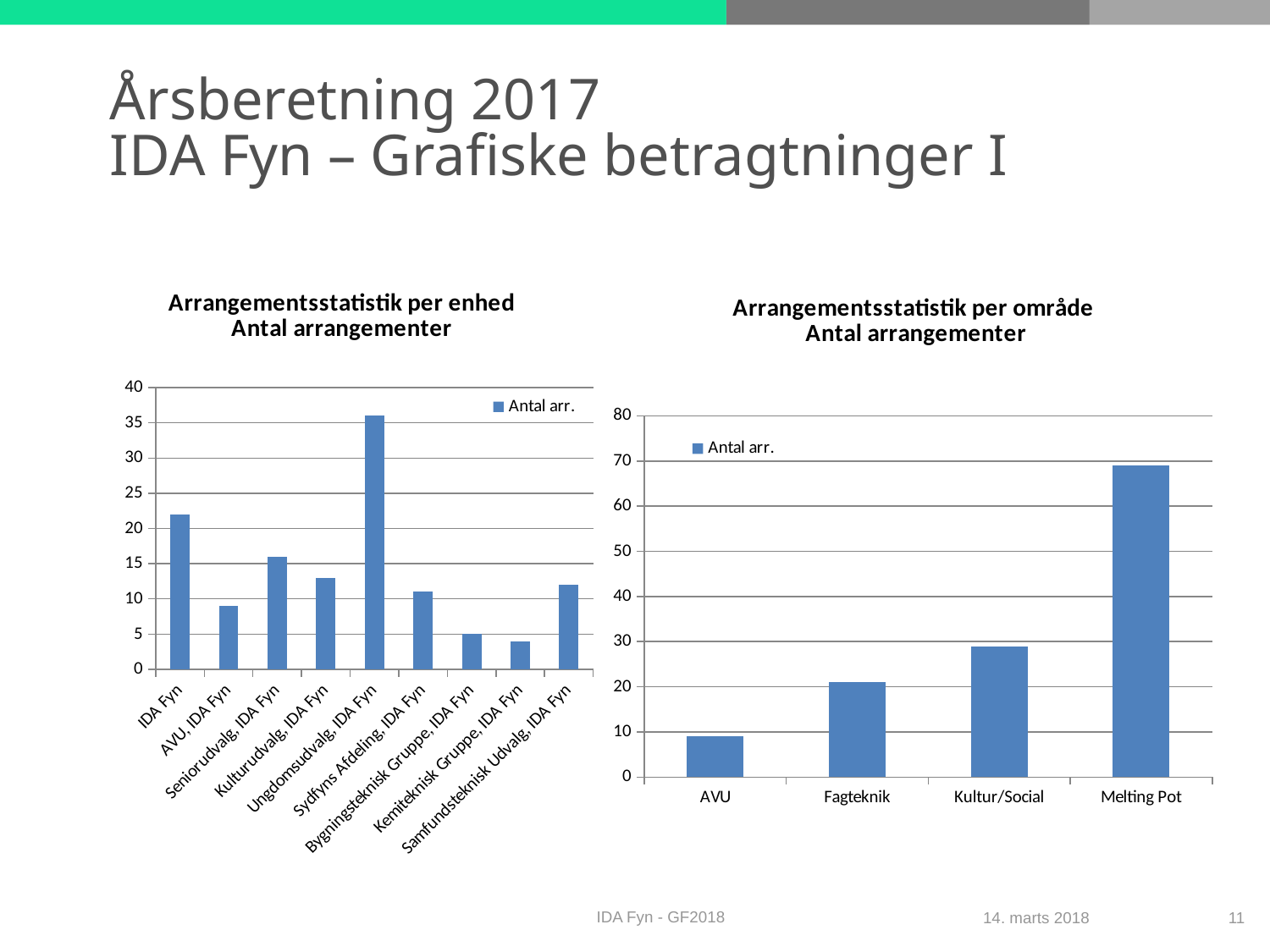
What type of chart is the chart titled 'Arrangementsstatistik per enhed'? Bar chart In the chart titled 'Arrangementsstatistik per enhed', is the value for IDA Fyn greater or less than 20? greater In the chart titled 'Arrangementsstatistik per område', is the value for Melting Pot greater or less than 60? greater How many categories are shown in the chart titled 'Arrangementsstatistik per enhed'? 9 How many categories are shown in the chart titled 'Arrangementsstatistik per område'? 4 In the chart titled 'Arrangementsstatistik per enhed', which category has the lowest value? Kemiteknisk Gruppe, IDA Fyn In the chart titled 'Arrangementsstatistik per område', which is larger, Fagteknik or Kultur/Social? Kultur/Social In the chart titled 'Arrangementsstatistik per enhed', which is larger, Seniorudvalg, IDA Fyn or Kulturudvalg, IDA Fyn? Seniorudvalg, IDA Fyn In the chart titled 'Arrangementsstatistik per område', which category has the highest value? Melting Pot In the chart titled 'Arrangementsstatistik per område', which category has the lowest value? AVU In the chart titled 'Arrangementsstatistik per enhed', which category has the highest value? Ungdomsudvalg, IDA Fyn